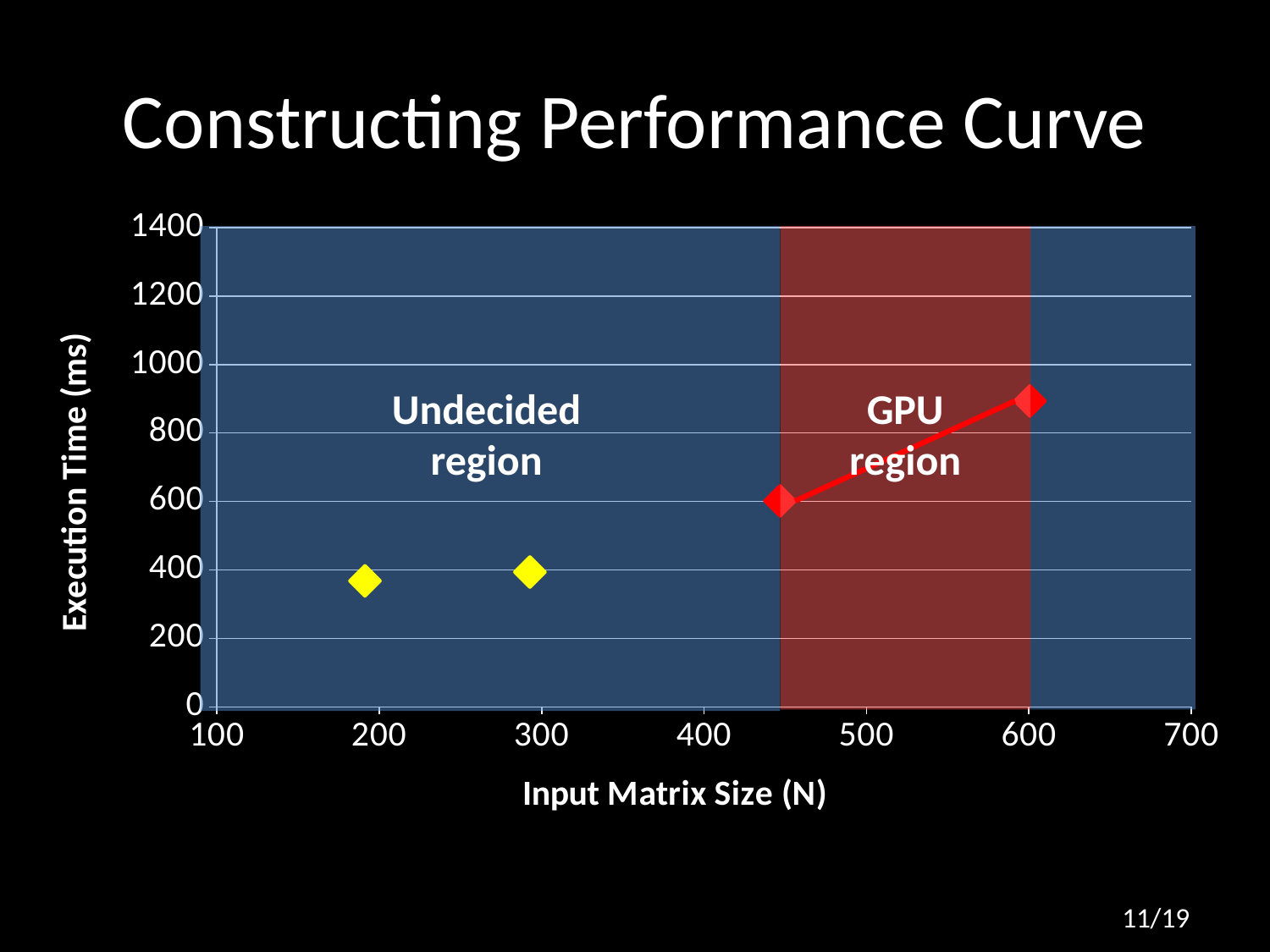
Is the execution time of the red point at the right edge of the GPU region (near N = 600) greater or less than 800 ms? greater How many yellow data points are plotted in the Undecided region? 2 What is the title of the chart on the slide? Constructing Performance Curve Is the execution time of the red point at the left edge of the GPU region (near N = 450) greater or less than 800 ms? less In which labelled region does the point with the highest execution time lie? GPU region Which has the higher execution time: the red point near N = 600 or the yellow point near N = 300? the red point near N = 600 How many red data points are plotted in the GPU region? 2 How many data points are plotted on the chart? 4 What kind of chart is shown on the slide? scatter chart Is the execution time of the yellow point near N = 200 greater or less than 600 ms? less What is the label of the x axis? Input Matrix Size (N) Does execution time rise or fall as the input matrix size increases along the x axis? rise